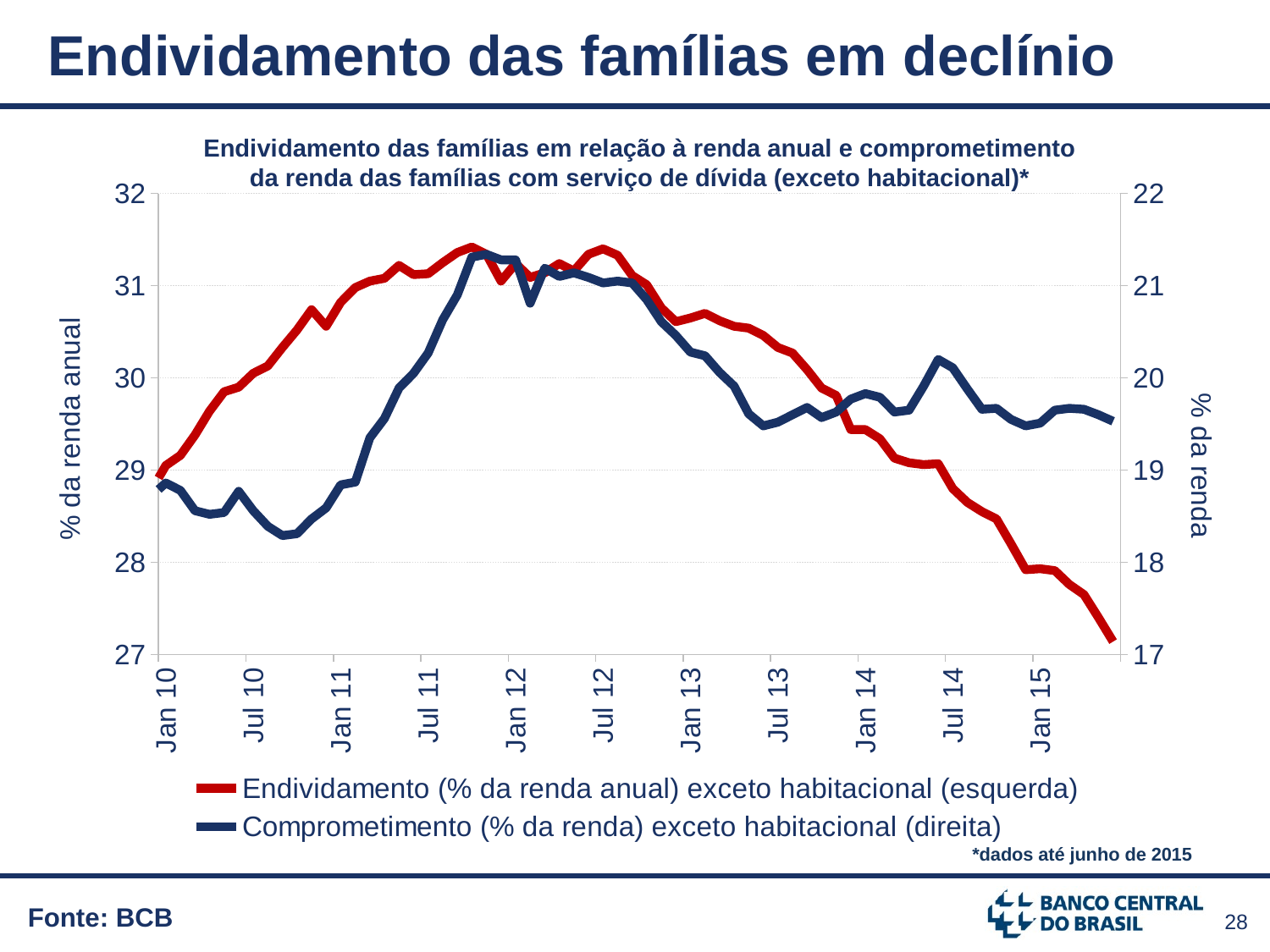
Which series is plotted against the right-hand axis? Comprometimento (% da renda) exceto habitacional (direita) Is the value of the Endividamento (red) line at the end of the series (mid-2015) greater or less than 28 on the left axis? less Does the Endividamento (red) line rise or fall between Jan 10 and Jul 11? rise Is the value of the Comprometimento (blue) line at Jan 12 greater or less than 21 on the right axis? greater Is the value of the Comprometimento (blue) line at Jan 15 greater or less than 20 on the right axis? less Does the Endividamento (red) line rise or fall between Jul 12 and the end of the series? fall How many series does the legend list? 2 What colour is the line for Endividamento (% da renda anual) exceto habitacional? red How many tick labels are shown on the x axis? 11 What kind of chart is shown on the slide? line chart